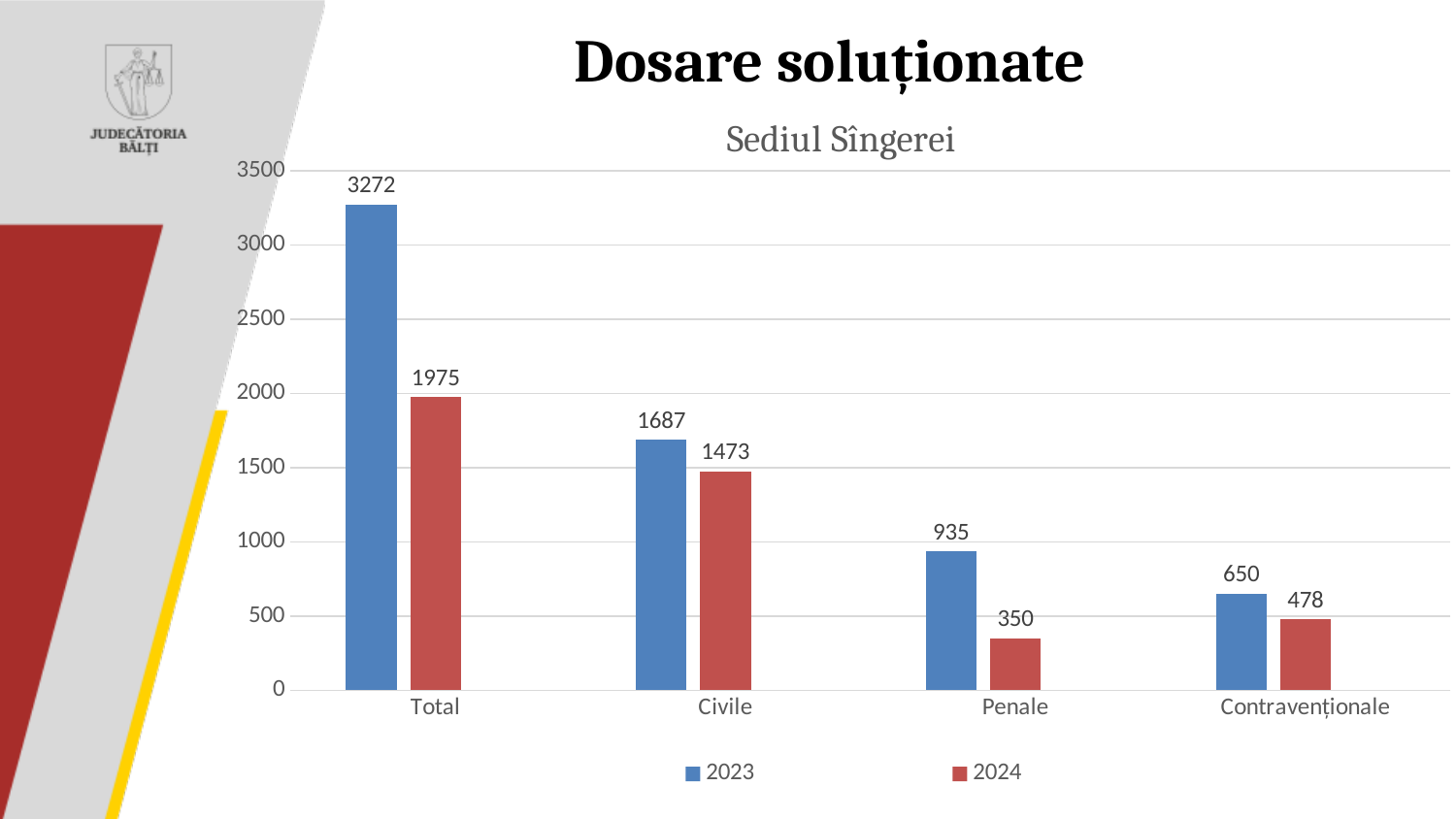
Which is larger, the 2023 value for Civile or the 2024 value for Civile? 2023 Which category has the lowest value in the 2024 series? Penale Which category has the highest value in the 2023 series? Total What is the value for Total in 2023? 3272 What is the value for Civile in 2024? 1473 What is the difference between the 2023 and 2024 values for Penale? 585 What kind of chart is shown on the slide? Bar chart How many categories are shown on the x axis? 4 What is the value for Penale in 2024? 350 What is the difference between the 2023 and 2024 values for Total? 1297 What is the value for Contravenționale in 2023? 650 How many series does the legend list? 2